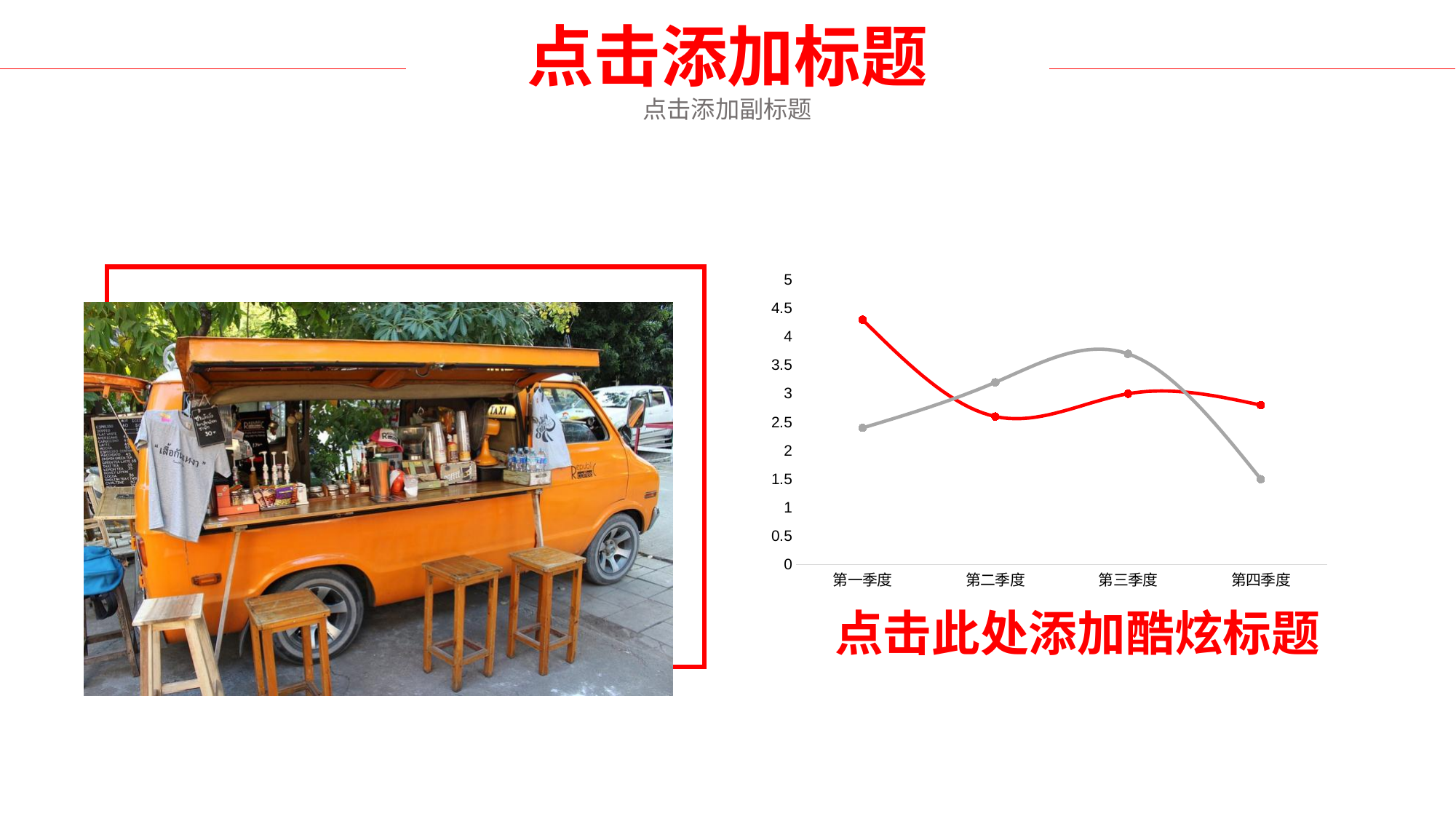
In the line chart, which quarter has the highest value on the red line? 第一季度 How many categories are shown on the x axis of the line chart? 4 In the line chart, is the gray line's value for 第四季度 greater or less than 2? less What kind of chart is shown on the right side of the slide? line chart In the line chart, is the red line's value for 第一季度 greater or less than 4? greater In the line chart, which quarter has the highest value on the gray line? 第三季度 In the line chart, is the gray line's value for 第一季度 greater or less than 3? less In the line chart, which quarter has the lowest value on the gray line? 第四季度 How many lines (series) are plotted in the line chart? 2 In the line chart, at 第一季度, which line has the larger value, the red line or the gray line? red line